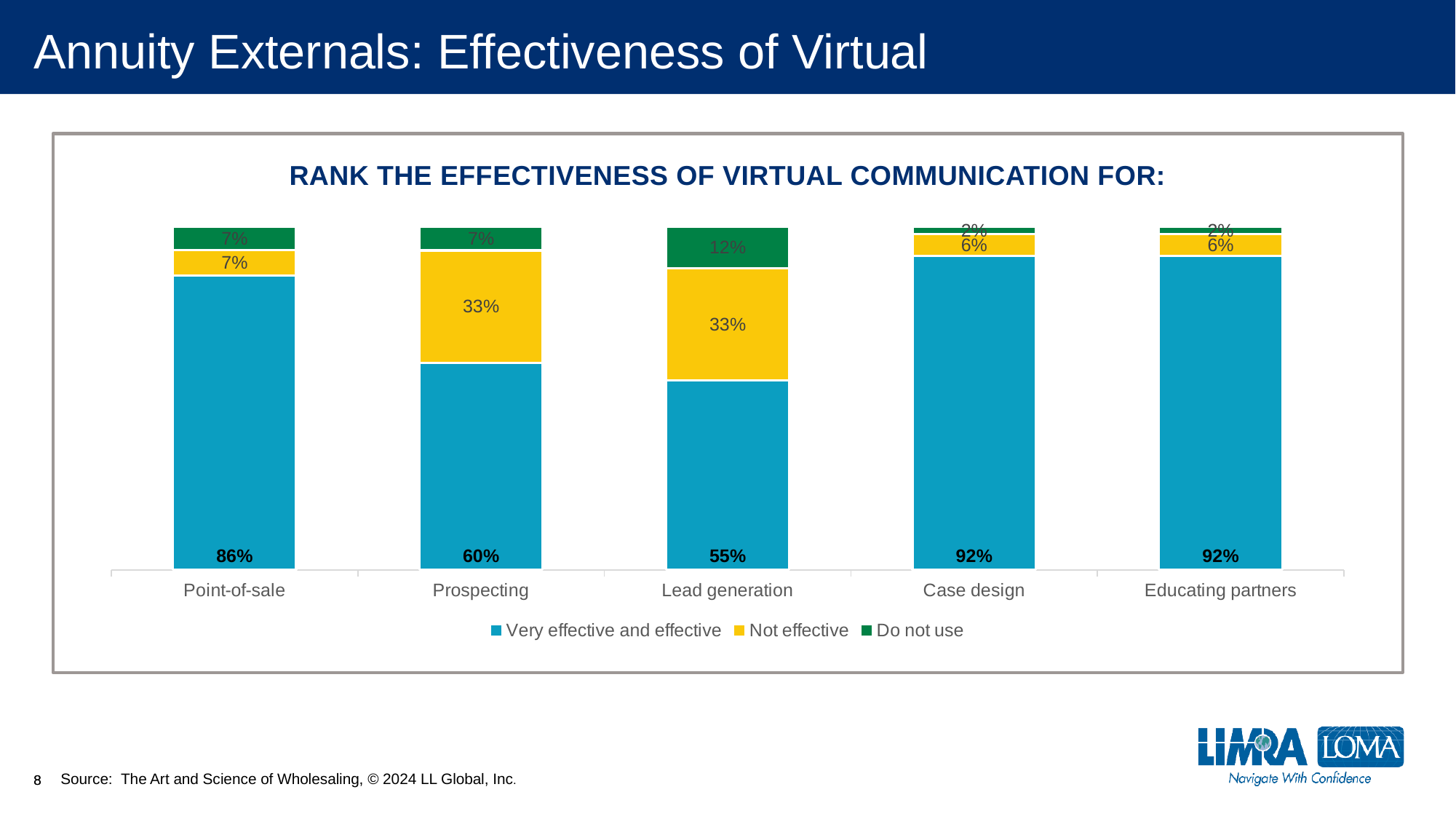
What kind of chart is shown on the slide? Stacked bar chart How many categories are shown on the x axis? 5 Which is larger: the 'Not effective' value for Point-of-sale or for Lead generation? Lead generation What is the 'Not effective' value for Prospecting? 33% What is the 'Do not use' value for Lead generation? 12% What is the 'Very effective and effective' value for Case design? 92% Which category has the lowest 'Very effective and effective' value? Lead generation What is the total of the stacked bar for Educating partners? 100% What is the difference between the 'Very effective and effective' values for Point-of-sale and Prospecting? 26% How many series does the legend list? 3 What percentage of respondents rated virtual communication as very effective and effective for Point-of-sale? 86% Which category has the highest 'Do not use' value? Lead generation